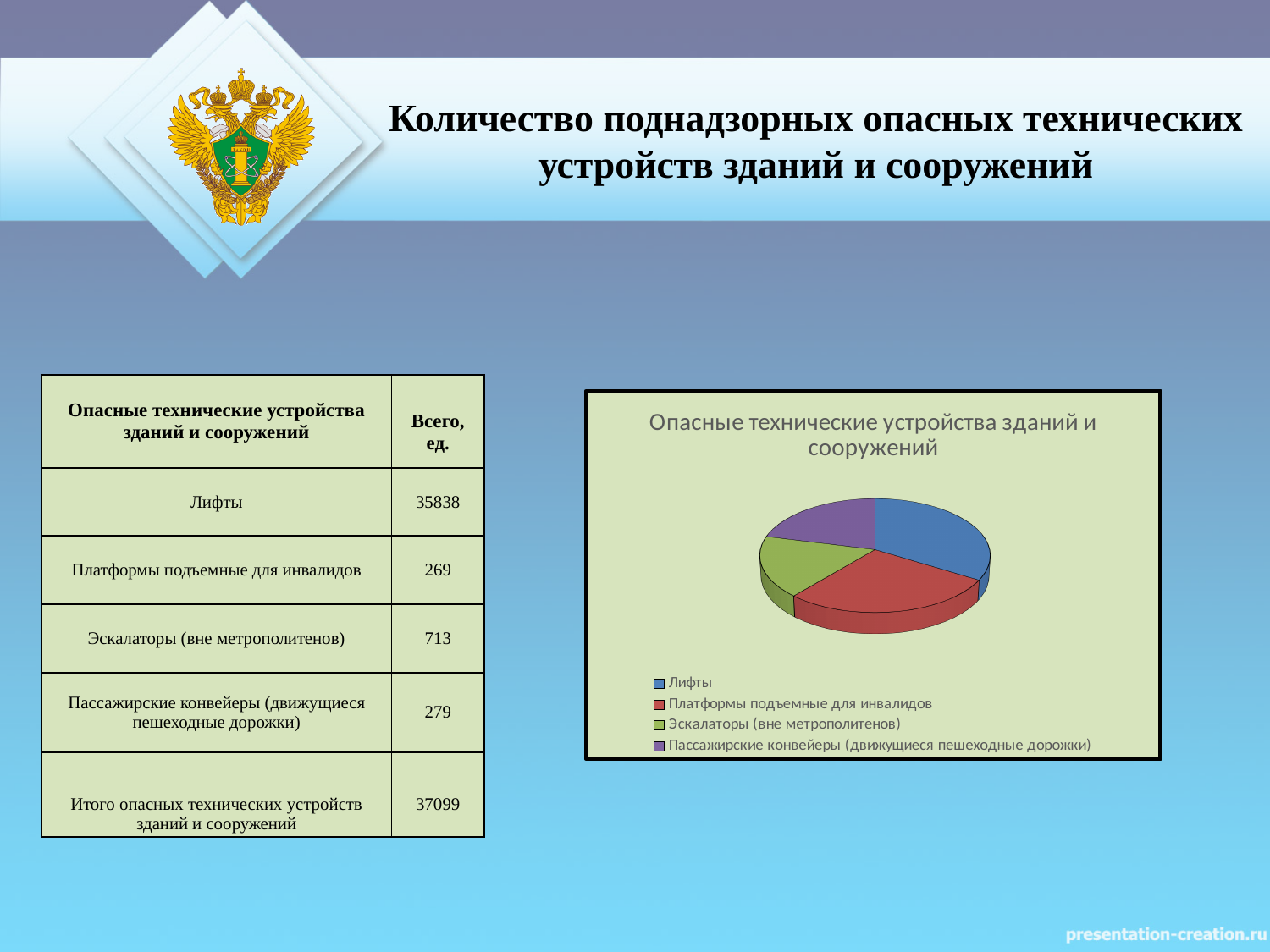
Which colour represents Лифты in the pie chart? blue What is the title of the pie chart? Опасные технические устройства зданий и сооружений In the pie chart, which slice is larger: Лифты or Эскалаторы (вне метрополитенов)? Лифты How many slices does the pie chart have? 4 What kind of chart is shown on the slide? pie chart In the pie chart, which slice is larger: Платформы подъемные для инвалидов or Пассажирские конвейеры (движущиеся пешеходные дорожки)? Платформы подъемные для инвалидов In the pie chart, which slice is larger: Платформы подъемные для инвалидов or Эскалаторы (вне метрополитенов)? Платформы подъемные для инвалидов How many entries does the legend of the pie chart list? 4